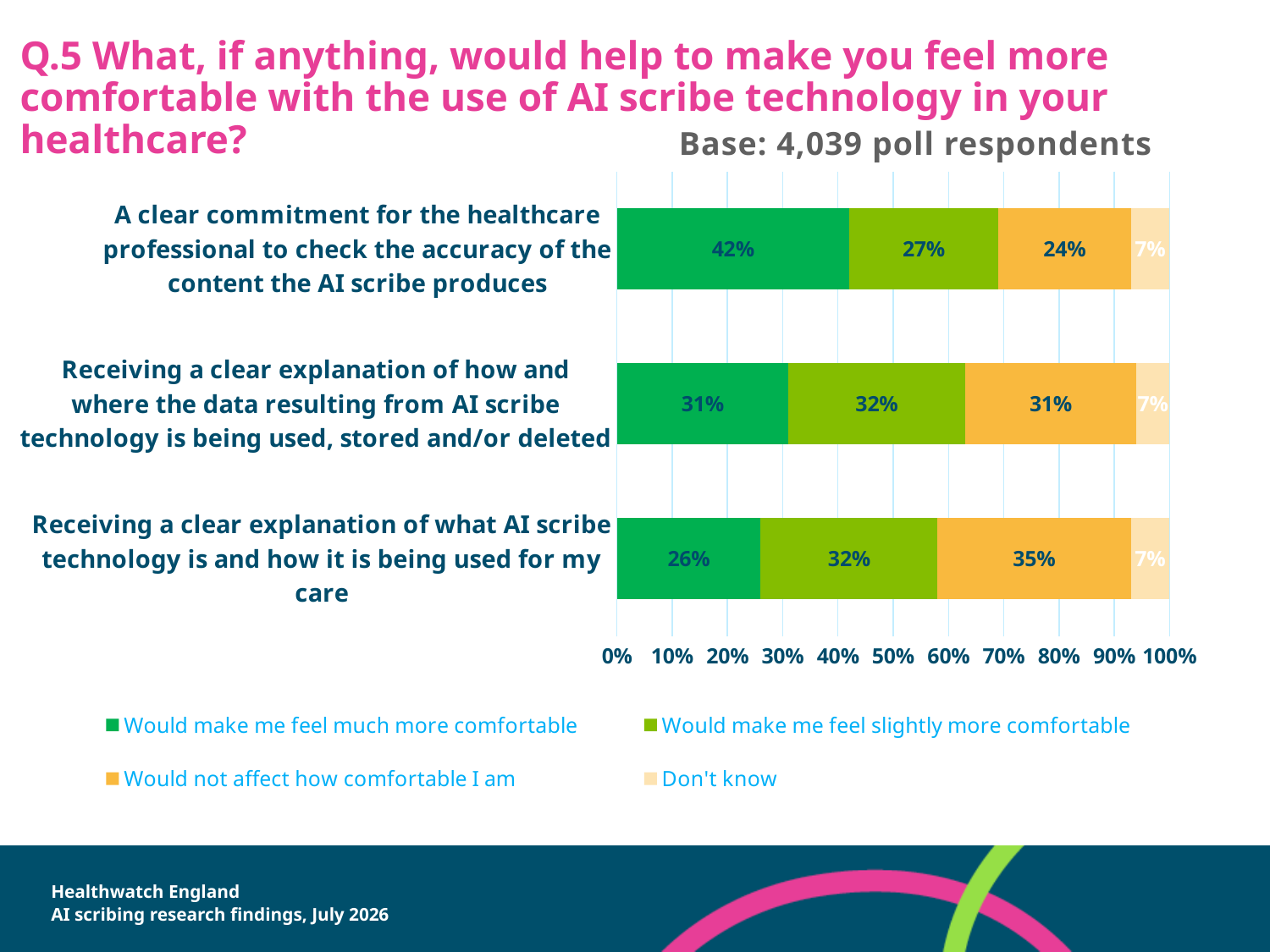
What is the base number of poll respondents stated on the slide? 4,039 What percentage of respondents said a clear commitment for the healthcare professional to check the accuracy of the AI scribe content would make them feel much more comfortable? 42% What is the 'Don't know' percentage for the option about a clear commitment to check the accuracy of the AI scribe content? 7% Which option has the lowest percentage of respondents saying it would make them feel much more comfortable? Receiving a clear explanation of what AI scribe technology is and how it is being used for my care What percentage said receiving a clear explanation of what AI scribe technology is and how it is being used for their care would not affect how comfortable they are? 35% What is the difference between the 'much more comfortable' percentages for the accuracy-check commitment option and the option about explaining what AI scribe technology is? 16% How many options (bars) are shown in the chart? 3 Which option has the highest percentage of respondents saying it would make them feel much more comfortable? A clear commitment for the healthcare professional to check the accuracy of the content the AI scribe produces What type of chart is shown on the slide? Stacked bar chart What percentage said receiving a clear explanation of how and where the data is being used, stored and/or deleted would make them feel slightly more comfortable? 32% For the option about explaining what AI scribe technology is and how it is used, which is larger: the share saying it would make them feel much more comfortable or the share saying it would not affect how comfortable they are? Would not affect how comfortable I am How many series does the legend list? 4